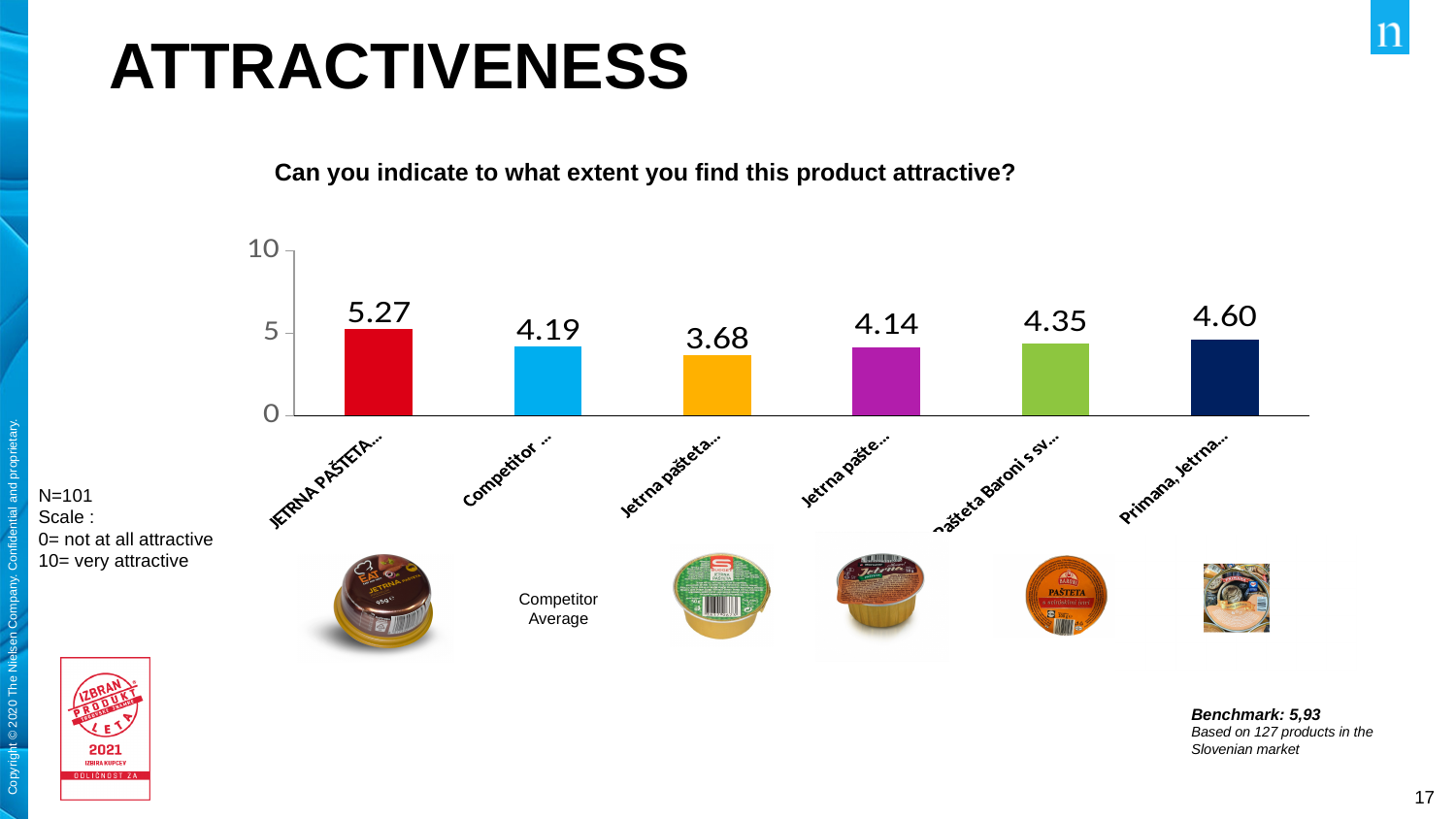
What is the value of the bar labelled Competitor ...? 4.19 How many bars are shown in the chart? 6 Is the value of the first bar greater or less than 5? greater What is the difference between the first bar (5.27) and the Competitor ... bar (4.19)? 1.08 What is the value of the first (red) bar, labelled JETRNA PAŠTETA...? 5.27 What type of chart is shown on the slide? Bar chart What is the lowest value shown in the chart? 3.68 Which bar has the highest value? JETRNA PAŠTETA... (5.27) Which is larger, the value for Pašteta Baroni s sv... or the value for Primana, Jetrna...? Primana, Jetrna... (4.60) What is the value of the bar labelled Pašteta Baroni s sv...? 4.35 What is the value of the last (dark blue) bar, labelled Primana, Jetrna...? 4.60 What is the maximum value shown on the vertical axis? 10